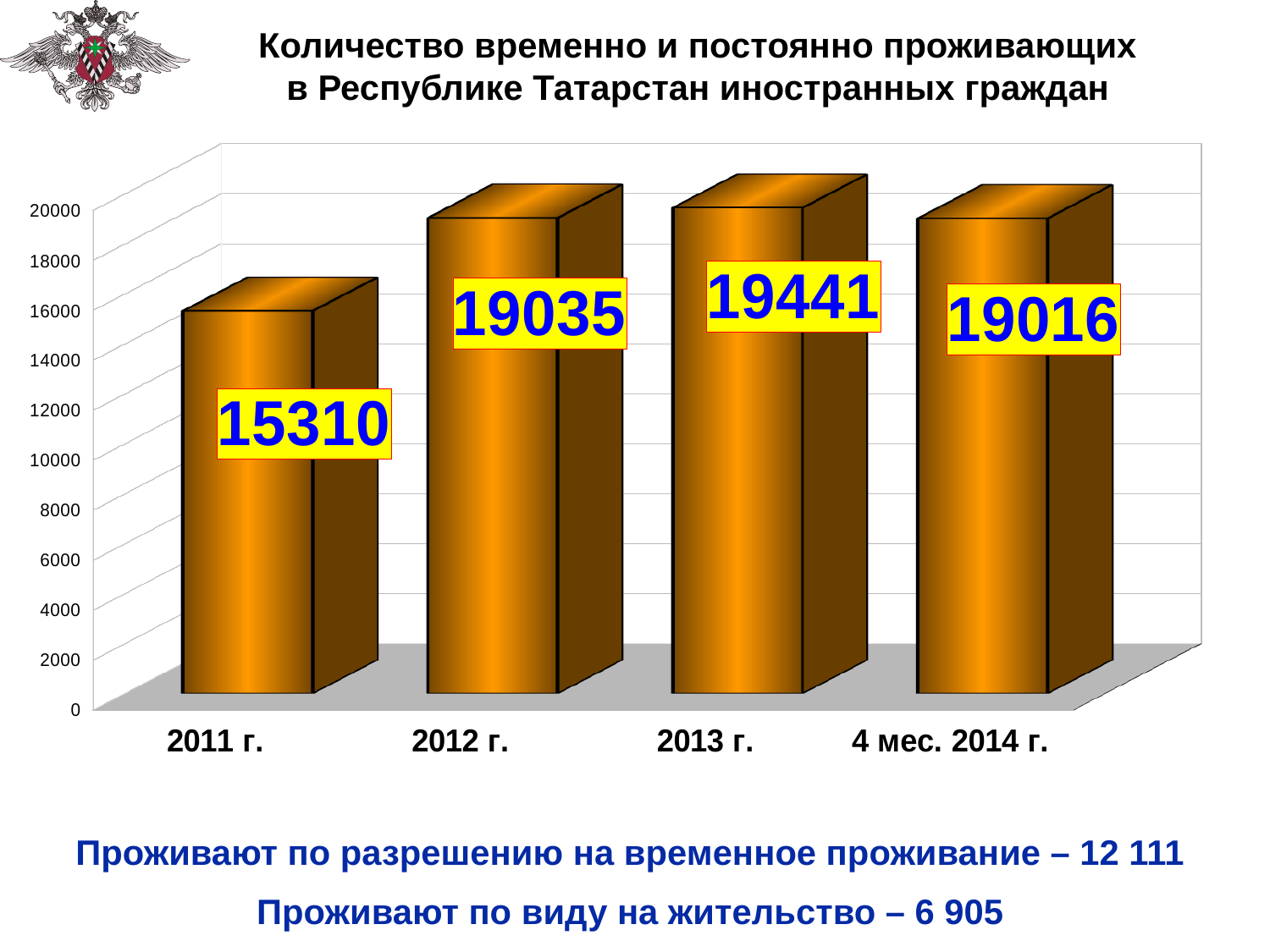
Which category has the highest value? 2013 г. What is the difference between the values for 2013 г. and 2011 г.? 4131 Which category has the lowest value? 2011 г. What is the value for 2011 г.? 15310 What is the difference between the values for 2012 г. and 4 мес. 2014 г.? 19 What is the title of the chart? Количество временно и постоянно проживающих в Республике Татарстан иностранных граждан What is the value for 2013 г.? 19441 What kind of chart is shown on the slide? bar chart How many categories are shown on the x axis? 4 Which is larger, the value for 2012 г. or the value for 2011 г.? 2012 г. What is the value for 2012 г.? 19035 What is the value for 4 мес. 2014 г.? 19016